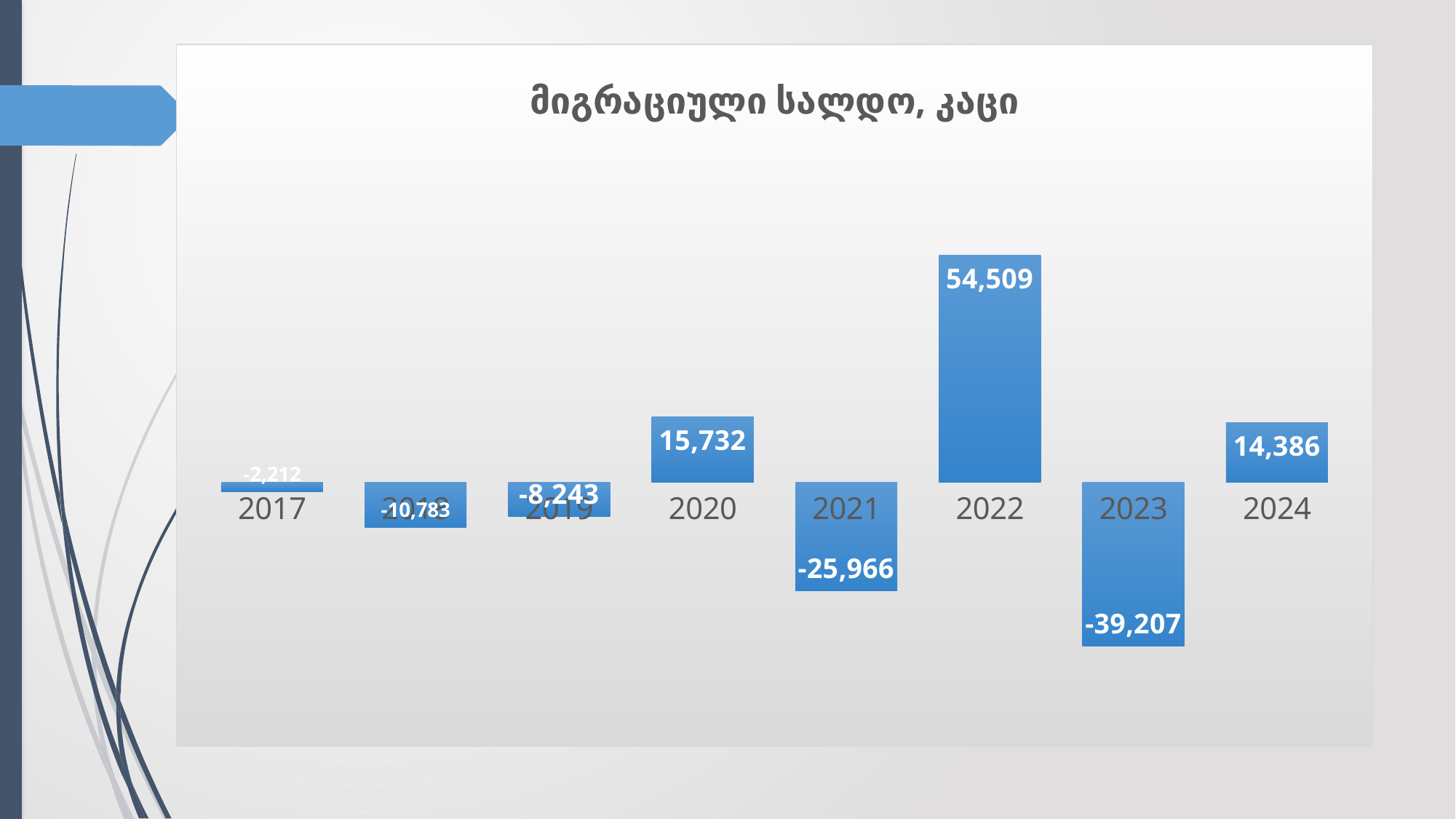
Which year has the larger value, 2020 or 2024? 2020 Which year has the lowest value? 2023 What is the value for 2024? 14,386 What is the value for 2020? 15,732 What is the value for 2017? -2,212 What kind of chart is shown on the slide? Bar chart How many years are shown on the x axis? 8 What is the value for 2023? -39,207 What is the difference between the values for 2022 and 2024? 40,123 What is the value for 2021? -25,966 Which year has the highest value? 2022 What is the value for 2022? 54,509